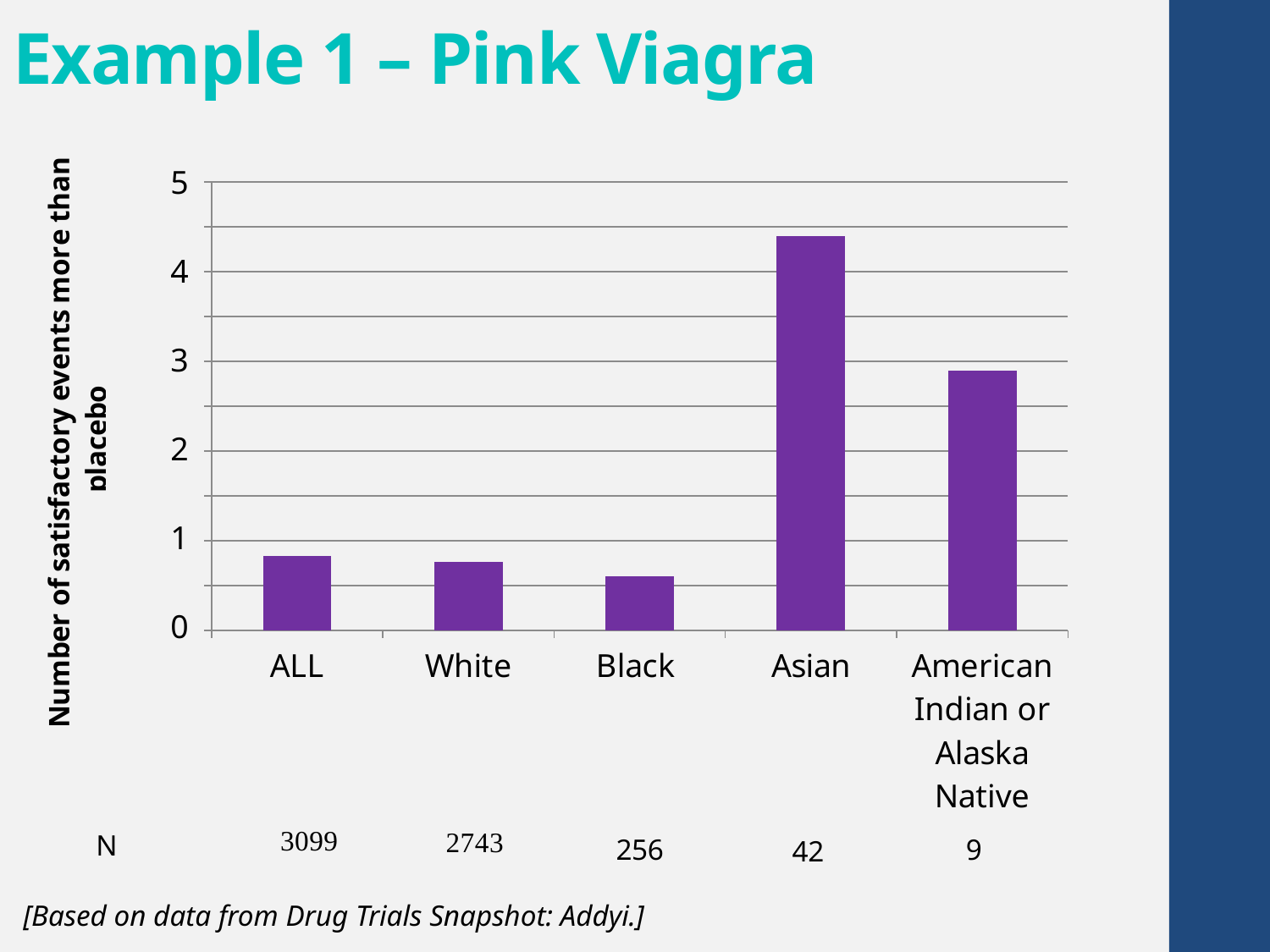
Which is larger, the value for Black or the value for American Indian or Alaska Native? American Indian or Alaska Native Which category has the lowest number of satisfactory events more than placebo? Black Is the value for ALL greater or less than 1? less Is the value for Black greater or less than 1? less Is the value for Asian greater or less than 4? greater What is the title of the vertical axis of the chart? Number of satisfactory events more than placebo Which is larger, the value for Asian or the value for American Indian or Alaska Native? Asian Which category has the highest number of satisfactory events more than placebo? Asian What kind of chart is shown on the slide? bar chart What is the N shown below the chart for the Asian category? 42 How many categories are shown on the x axis of the chart? 5